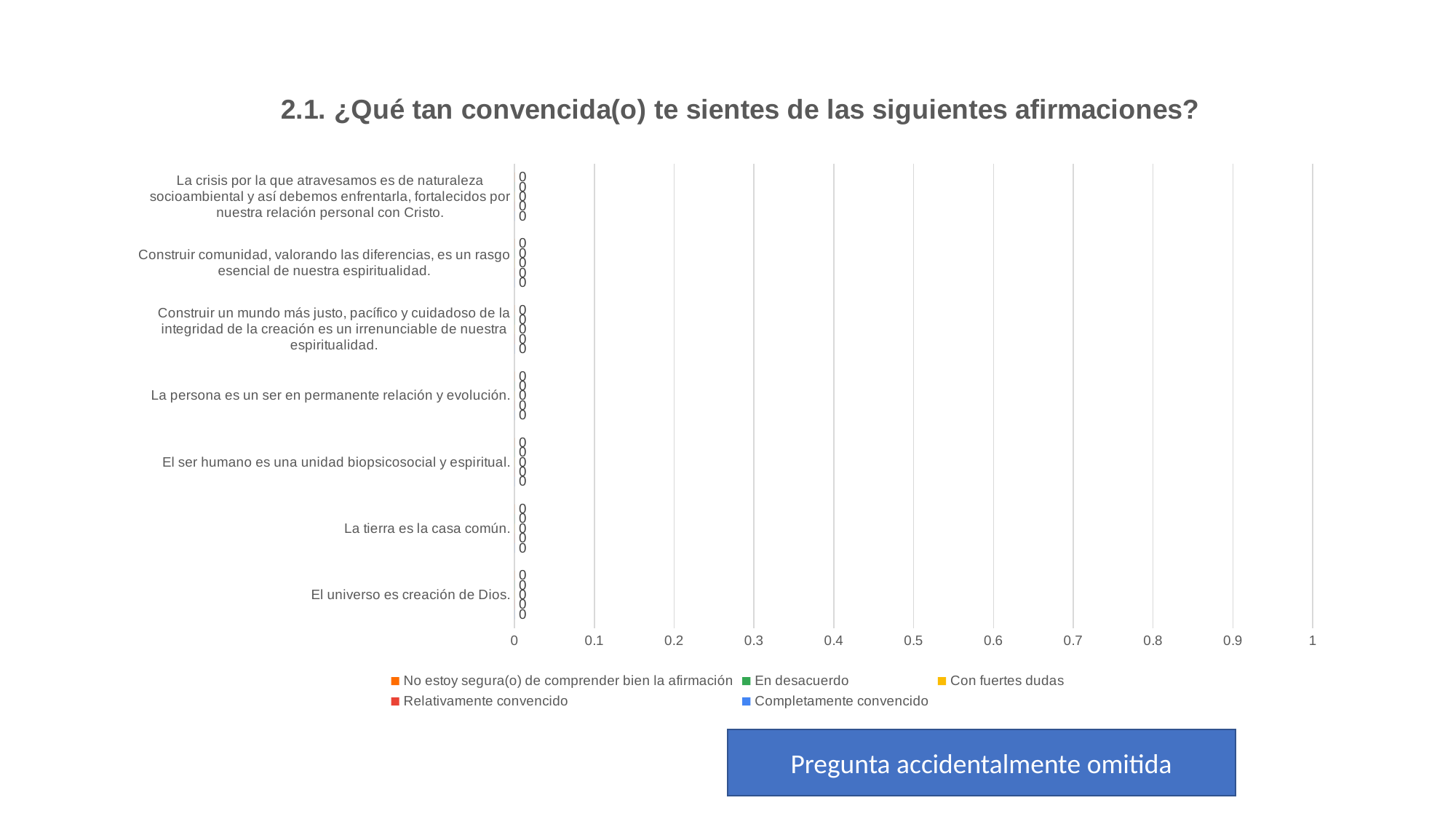
What is the title of the chart? 2.1. ¿Qué tan convencida(o) te sientes de las siguientes afirmaciones? Is the value of 'Completamente convencido' for 'La tierra es la casa común.' greater or less than 0.5? less How many series does the chart's legend list? 5 What is the value of 'En desacuerdo' for 'La tierra es la casa común.'? 0 What is the value of 'Con fuertes dudas' for 'La persona es un ser en permanente relación y evolución.'? 0 What is the value of 'Completamente convencido' for 'El universo es creación de Dios.'? 0 How many categories (statements) are listed on the vertical axis of the chart? 7 What kind of chart is shown on the slide? bar chart What is the value of 'No estoy segura(o) de comprender bien la afirmación' for 'Construir comunidad, valorando las diferencias, es un rasgo esencial de nuestra espiritualidad.'? 0 What is the difference between the 'Relativamente convencido' values for 'La tierra es la casa común.' and 'El universo es creación de Dios.'? 0 What is the total of all series for 'El ser humano es una unidad biopsicosocial y espiritual.'? 0 What is the highest value shown on the horizontal axis of the chart? 1